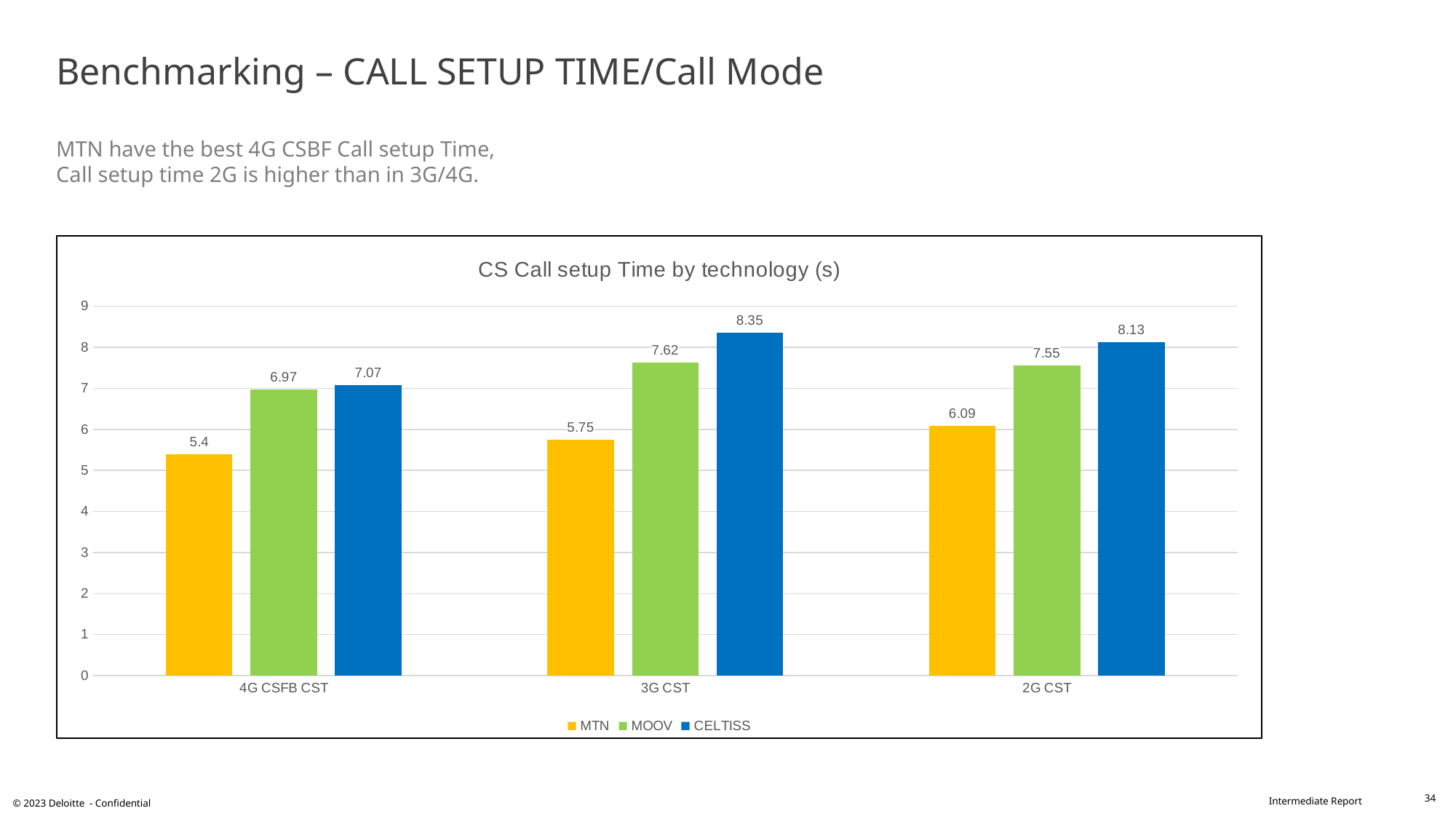
What is the value for MTN in the 4G CSFB CST category? 5.4 What is the value for CELTISS in the 3G CST category? 8.35 Is the value for CELTISS in the 2G CST category greater or less than 8? greater What is the title of the chart? CS Call setup Time by technology (s) Which operator has the lowest call setup time in the 3G CST category? MTN What kind of chart is shown on the slide? Bar chart What is the difference between the CELTISS and MTN values in the 3G CST category? 2.6 What is the value for MOOV in the 2G CST category? 7.55 Which operator has the highest call setup time in the 2G CST category? CELTISS How many categories are shown on the x axis? 3 How many series does the legend list? 3 Which is larger: the MOOV value for 4G CSFB CST or the MOOV value for 3G CST? 3G CST